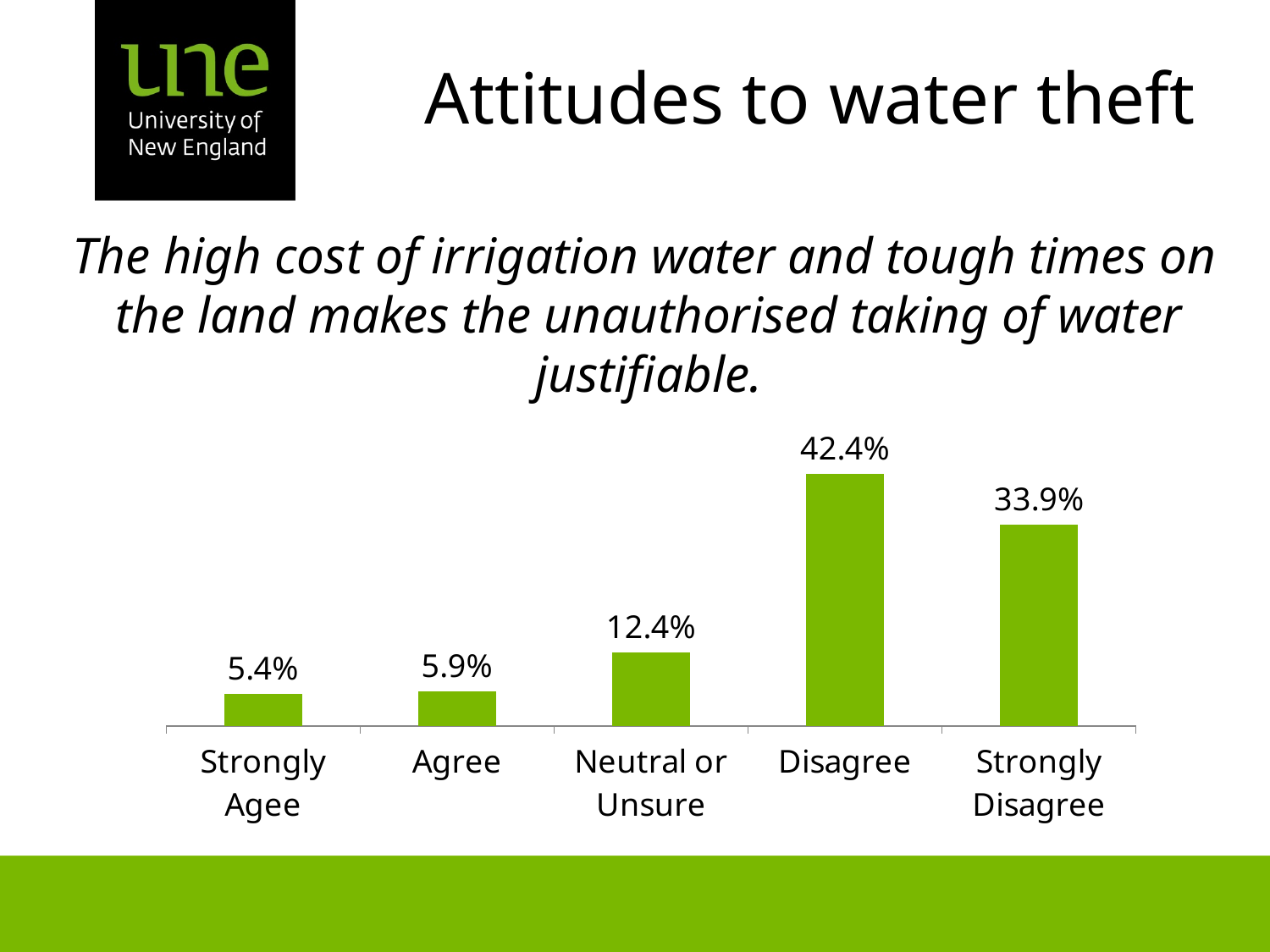
What is the value shown for Neutral or Unsure? 12.4% What percentage is shown for Strongly Disagree? 33.9% What is the difference between the Disagree and Strongly Disagree values? 8.5% Which is larger, the value for Agree or the value for Neutral or Unsure? Neutral or Unsure What colour are the bars in the chart? Green What percentage of respondents chose Disagree? 42.4% What is the difference between the Neutral or Unsure and Agree values? 6.5% What kind of chart is shown on the slide? Bar chart What is the combined percentage of Strongly Agee and Agree responses? 11.3% Which response category has the highest value? Disagree How many response categories are shown on the chart? 5 Which response category has the lowest value? Strongly Agee